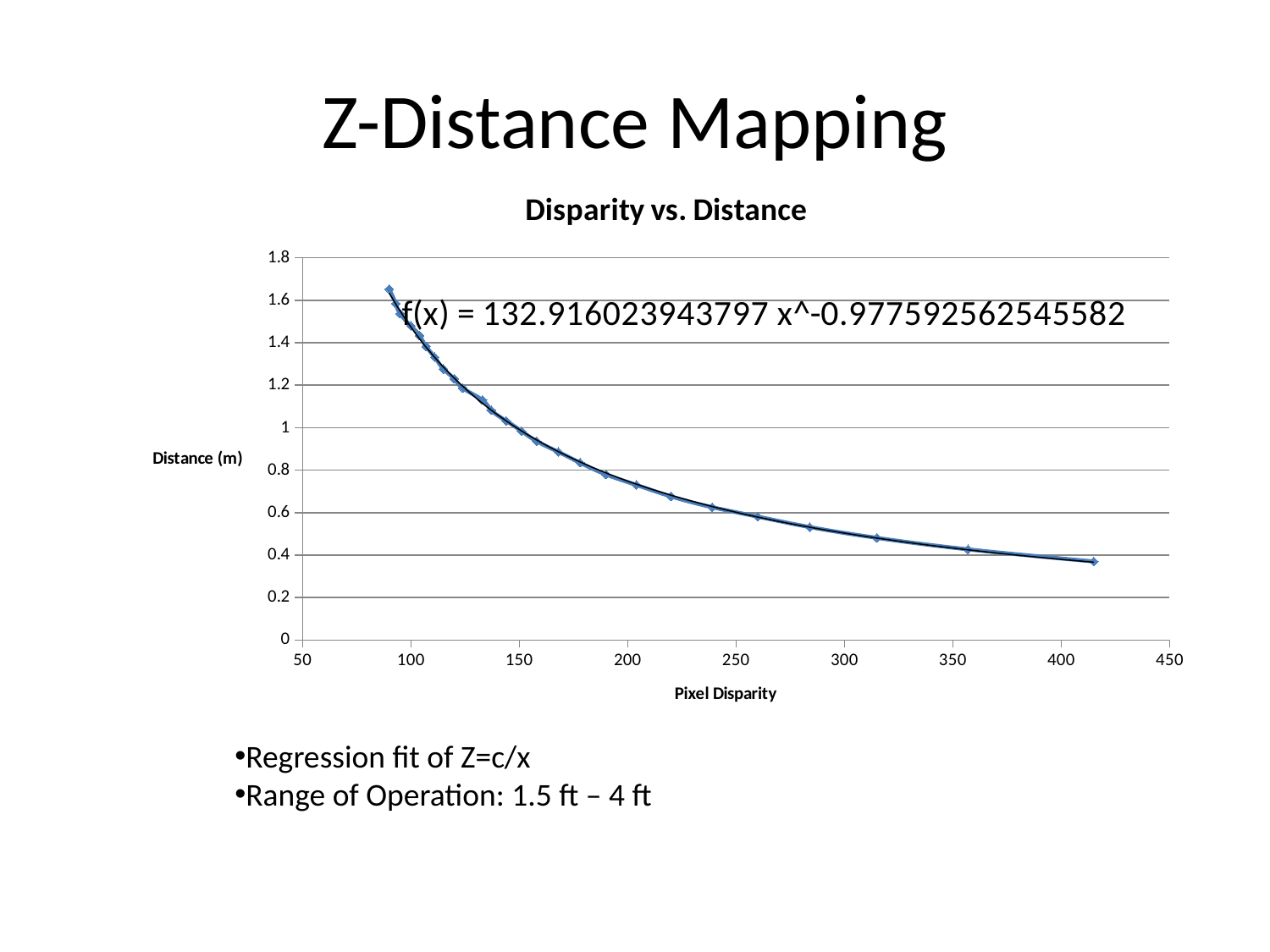
Is the distance at a pixel disparity of 100 greater or less than 1.2? greater What is the label of the x axis of the chart? Pixel Disparity As pixel disparity increases along the x axis, does the distance rise or fall? Fall Which has the larger distance: the point at pixel disparity 100 or the point at pixel disparity 300? The point at pixel disparity 100 Is the distance at a pixel disparity of 300 greater or less than 0.6? less Is the distance at a pixel disparity of 120 greater or less than 1.0? greater What type of chart is shown on the slide? Scatter chart with a fitted trendline What is the title of the chart? Disparity vs. Distance